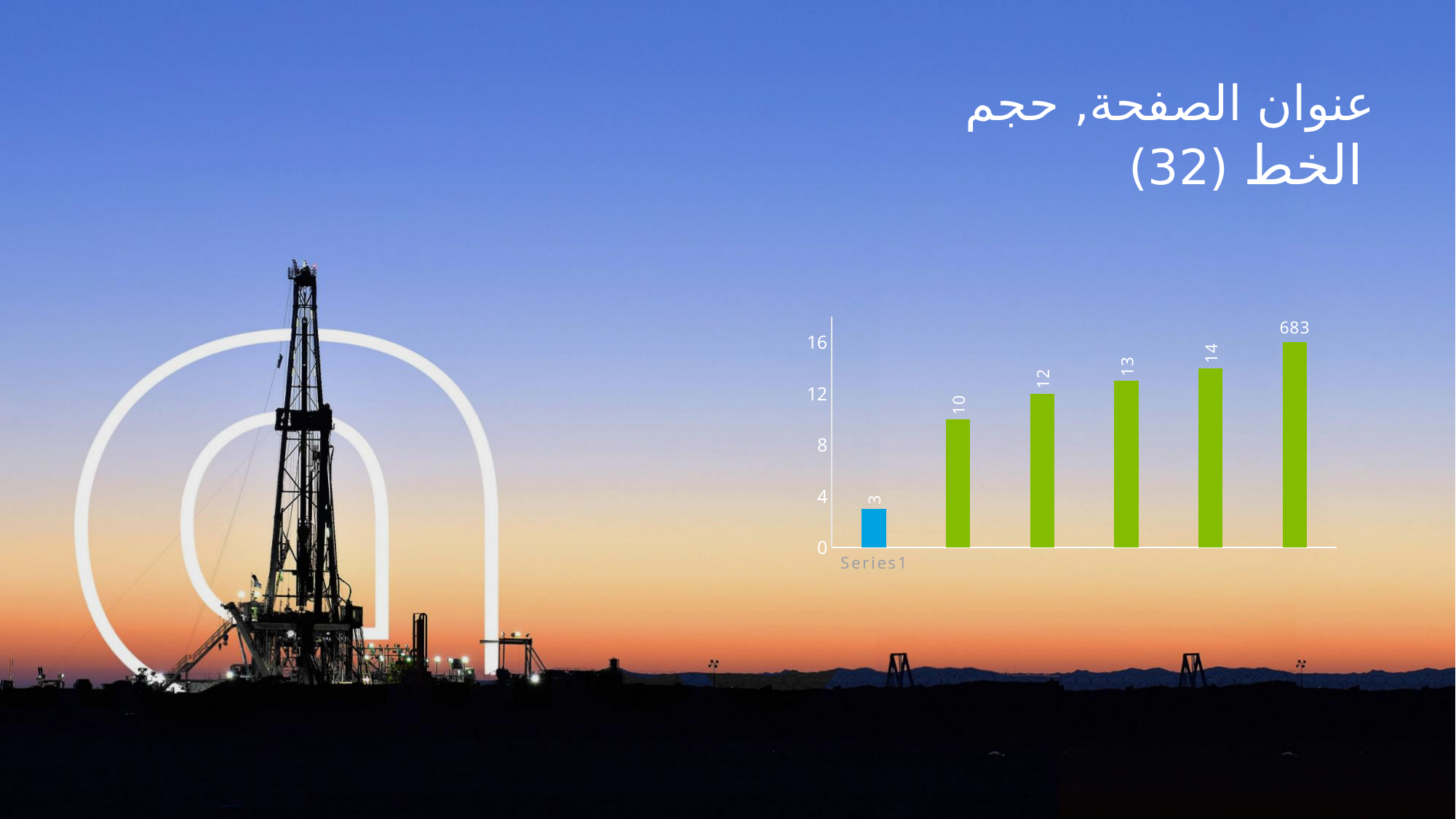
What data label is printed above the rightmost bar? 683 What colour is the leftmost bar compared with the other bars? blue; the others are green What is the value of the fourth bar from the left? 13 Which is larger, the third bar from the left or the leftmost bar? the third bar from the left What is the value of the bar labelled Series1 (the leftmost bar)? 3 Which bar is the shortest in the chart? the leftmost bar (Series1) What is the difference between the fifth bar (14) and the second bar (10)? 4 What is the value of the second bar from the left? 10 How many bars are plotted in the chart? 6 What type of chart is shown on the slide? bar chart Which bar is the tallest in the chart? the rightmost bar Do the bar values rise or fall from left to right across the chart? rise